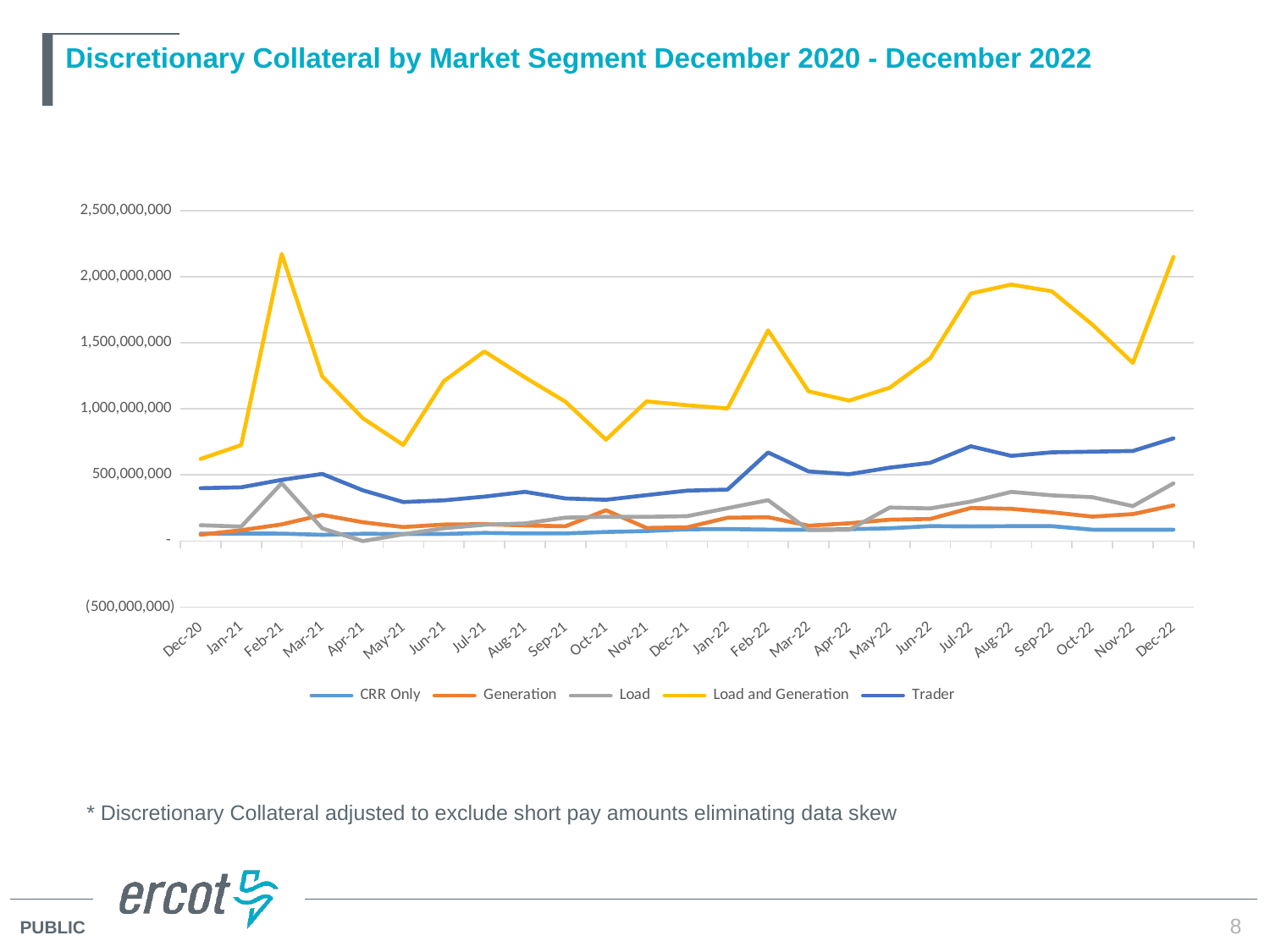
Which market segment has the highest discretionary collateral in Dec-22? Load and Generation In Dec-22, which is larger, the value for Trader or the value for Generation? Trader Is the value for Trader in Dec-22 greater or less than 500,000,000? greater What kind of chart is shown on the slide? Line chart How many months are plotted along the x axis? 25 Which series is drawn in yellow? Load and Generation What is the title of the chart? Discretionary Collateral by Market Segment December 2020 - December 2022 Does the Load and Generation line rise or fall from Apr-22 to Aug-22? rise Is the value for Trader in Apr-21 greater or less than 500,000,000? less How many series does the legend list? 5 Is the value for Load and Generation in Feb-21 greater or less than 2,000,000,000? greater